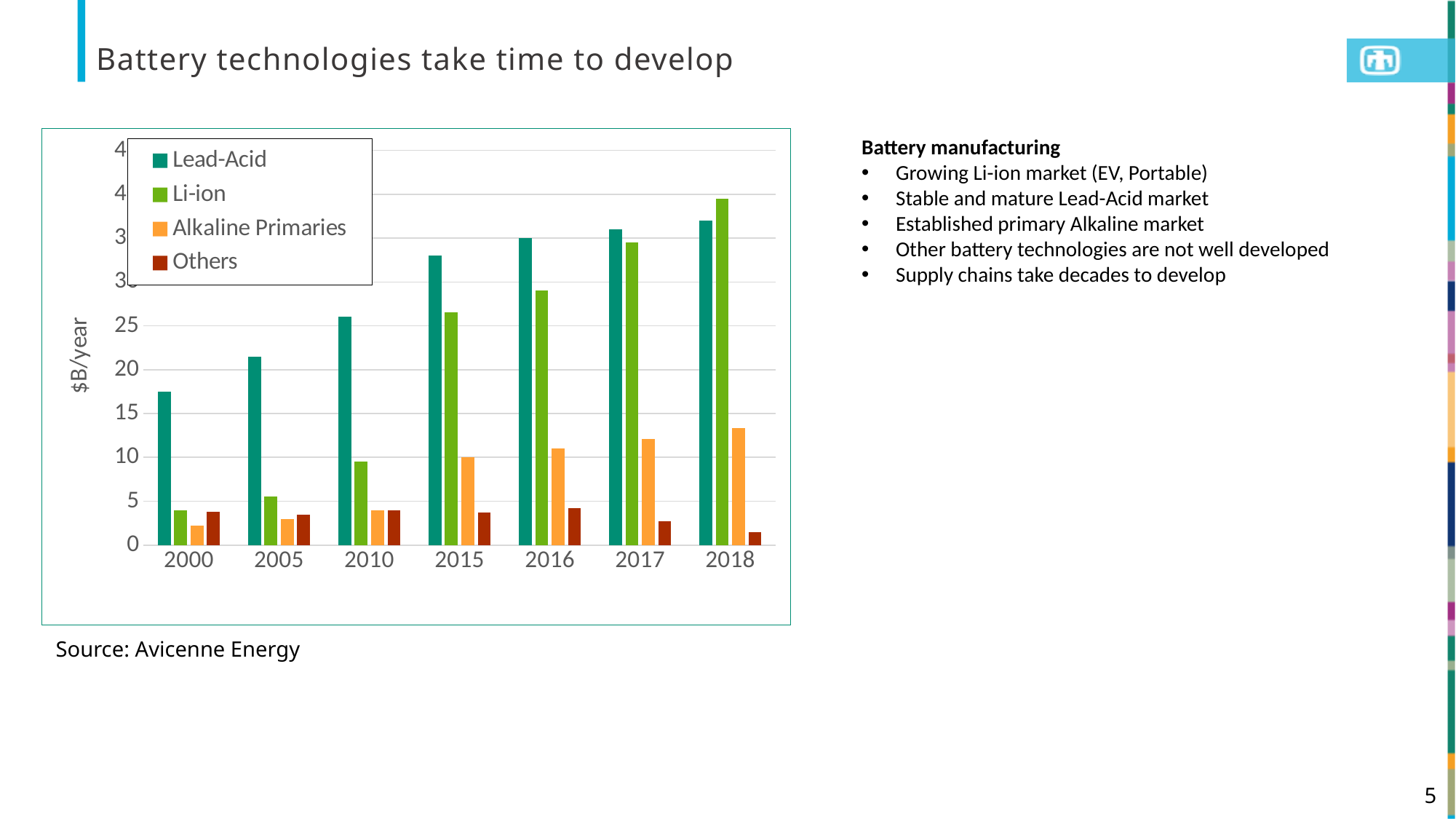
Is the value for Alkaline Primaries in 2017 greater or less than 10? greater How many series does the legend list? 4 Do the Li-ion values rise or fall from 2000 to 2018? Rise What is the label on the y axis? $B/year How many years are shown on the x axis? 7 Which series has the highest value in 2000? Lead-Acid In 2015, which is larger: Lead-Acid or Li-ion? Lead-Acid In 2018, which is larger: Li-ion or Lead-Acid? Li-ion Is the value for Lead-Acid in 2000 greater or less than 20? less What type of chart is shown on the slide? Bar chart Which series has the lowest value in 2018? Others Is the value for Li-ion in 2010 greater or less than 15? less